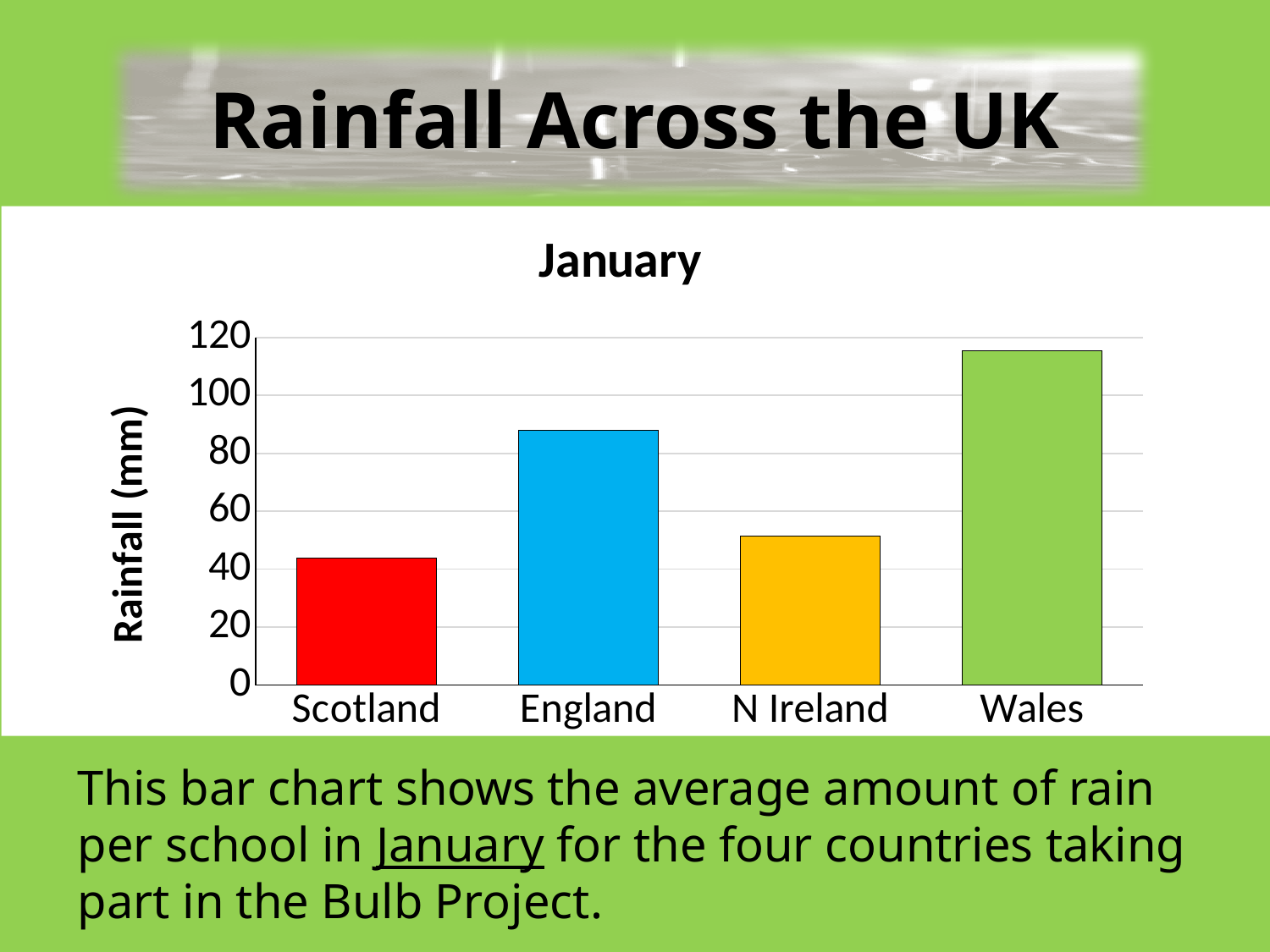
What is the title of the chart? January How many countries are shown on the chart? 4 Is the value for N Ireland greater or less than 60? less Which has the higher rainfall, England or N Ireland? England Is the value for Wales greater or less than 100? greater Is the value for England greater or less than 80? greater Which country has the lowest rainfall in the chart? Scotland What kind of chart is shown on the slide? bar chart Which country has the highest rainfall in the chart? Wales Which has the lower rainfall, Scotland or Wales? Scotland What is the label on the vertical axis of the chart? Rainfall (mm)